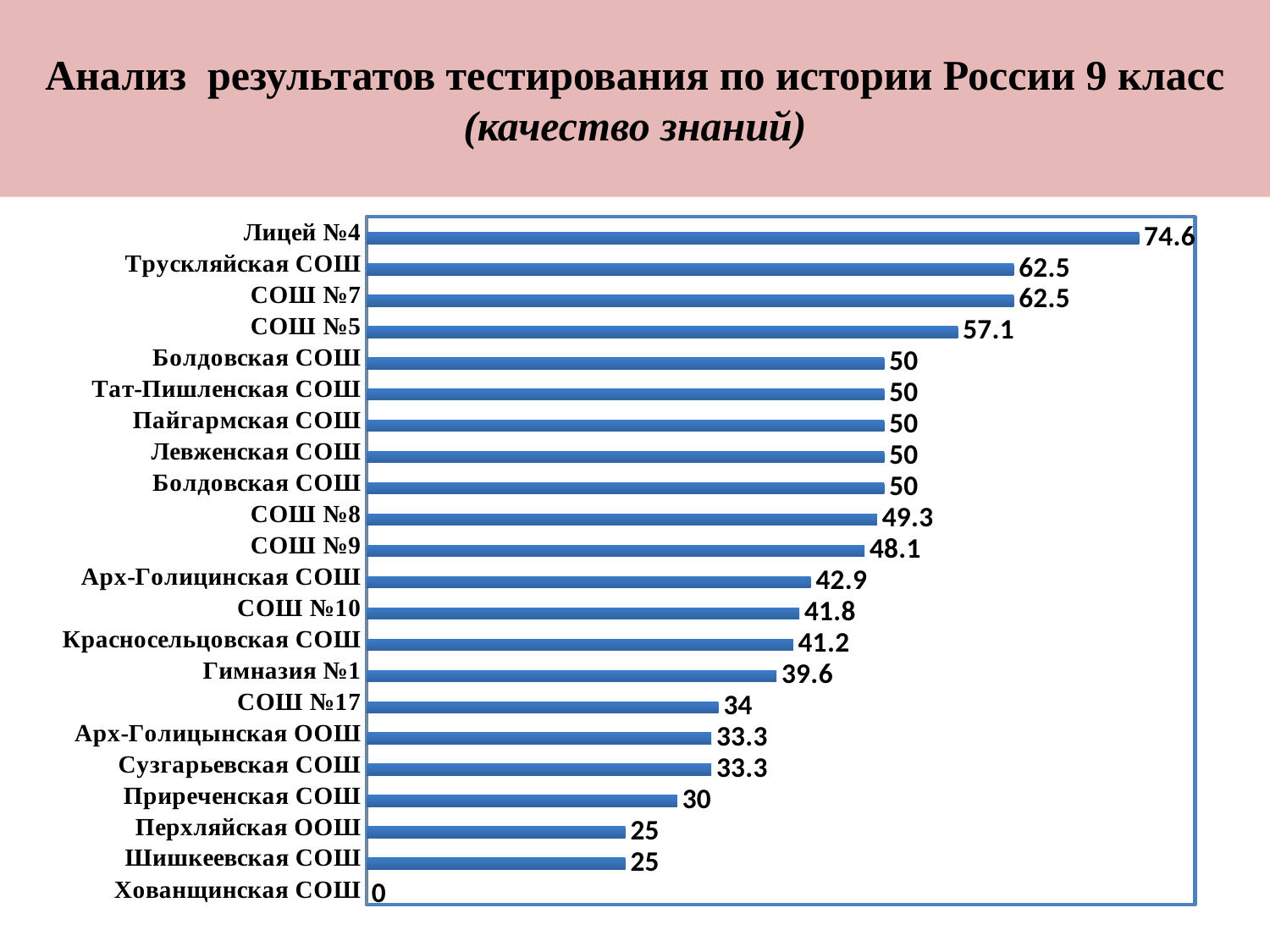
What is the value for СОШ №5? 57.1 What is the value for Шишкеевская СОШ? 25 Which is larger, the value for СОШ №10 or the value for Красносельцовская СОШ? СОШ №10 What is the value for Гимназия №1? 39.6 What is the difference between the values for СОШ №8 and СОШ №9? 1.2 Which school has the lowest value? Хованщинская СОШ Which school has the highest value? Лицей №4 What is the value for Приреченская СОШ? 30 What is the difference between the values for Лицей №4 and СОШ №7? 12.1 What kind of chart is shown on the slide? bar chart What is the value for Лицей №4? 74.6 How many schools are shown in the chart? 22